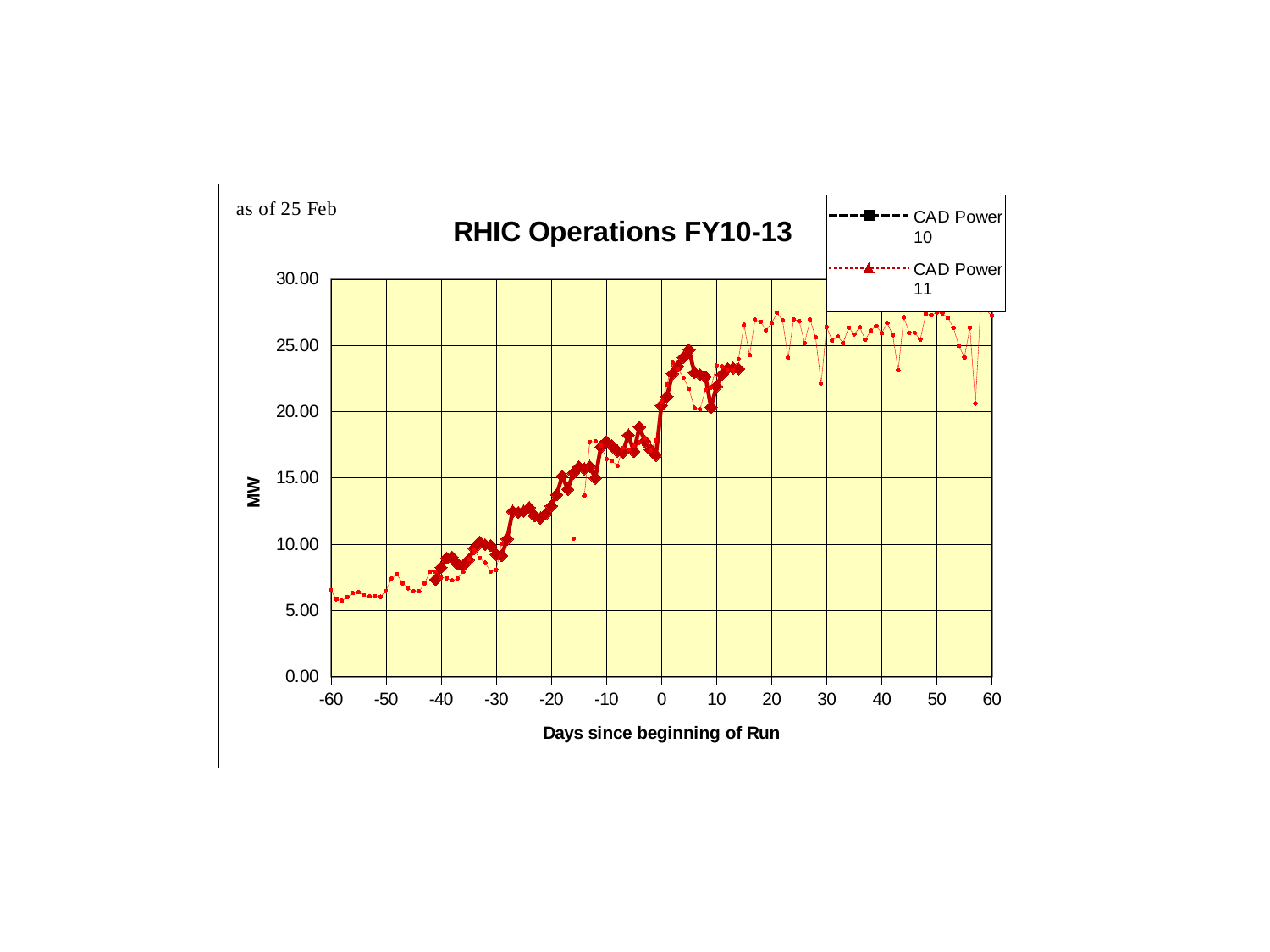
What is the title of the chart? RHIC Operations FY10-13 Is the value of the CAD Power 11 series at day 30 greater or less than 15.00 MW? greater Is the value of the CAD Power 11 series at day -60 greater or less than 5.00 MW? greater Is the value of the CAD Power 10 series at day -40 greater or less than 10.00 MW? less What is the label of the y axis? MW What kind of chart is shown on the slide? line chart Do the plotted values generally rise or fall as the days since beginning of run increase from -60 to 60? rise